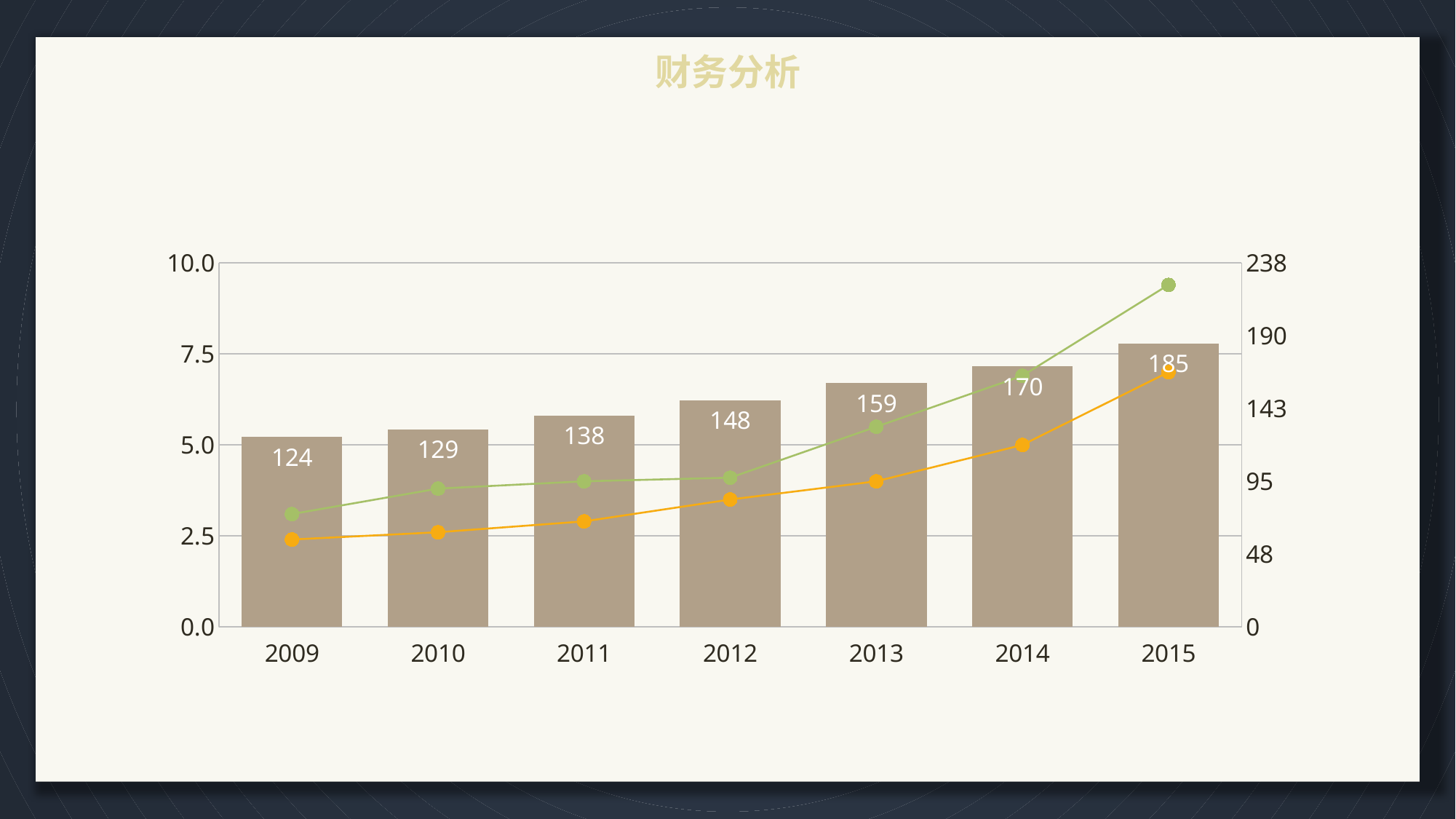
What is the title of the slide? 财务分析 What is the bar value for 2014? 170 What is the bar value for 2012? 148 Is the green line's value for 2015 greater or less than 7.5 on the left axis? greater Which year has the highest bar value? 2015 What is the difference between the bar values for 2013 and 2012? 11 What is the difference between the bar values for 2015 and 2009? 61 Which year has the lowest bar value? 2009 How many years are shown on the x axis? 7 What is the bar value for 2009? 124 Do the bar values rise or fall from 2009 to 2015? rise Which is larger, the bar value for 2011 or the bar value for 2013? 2013